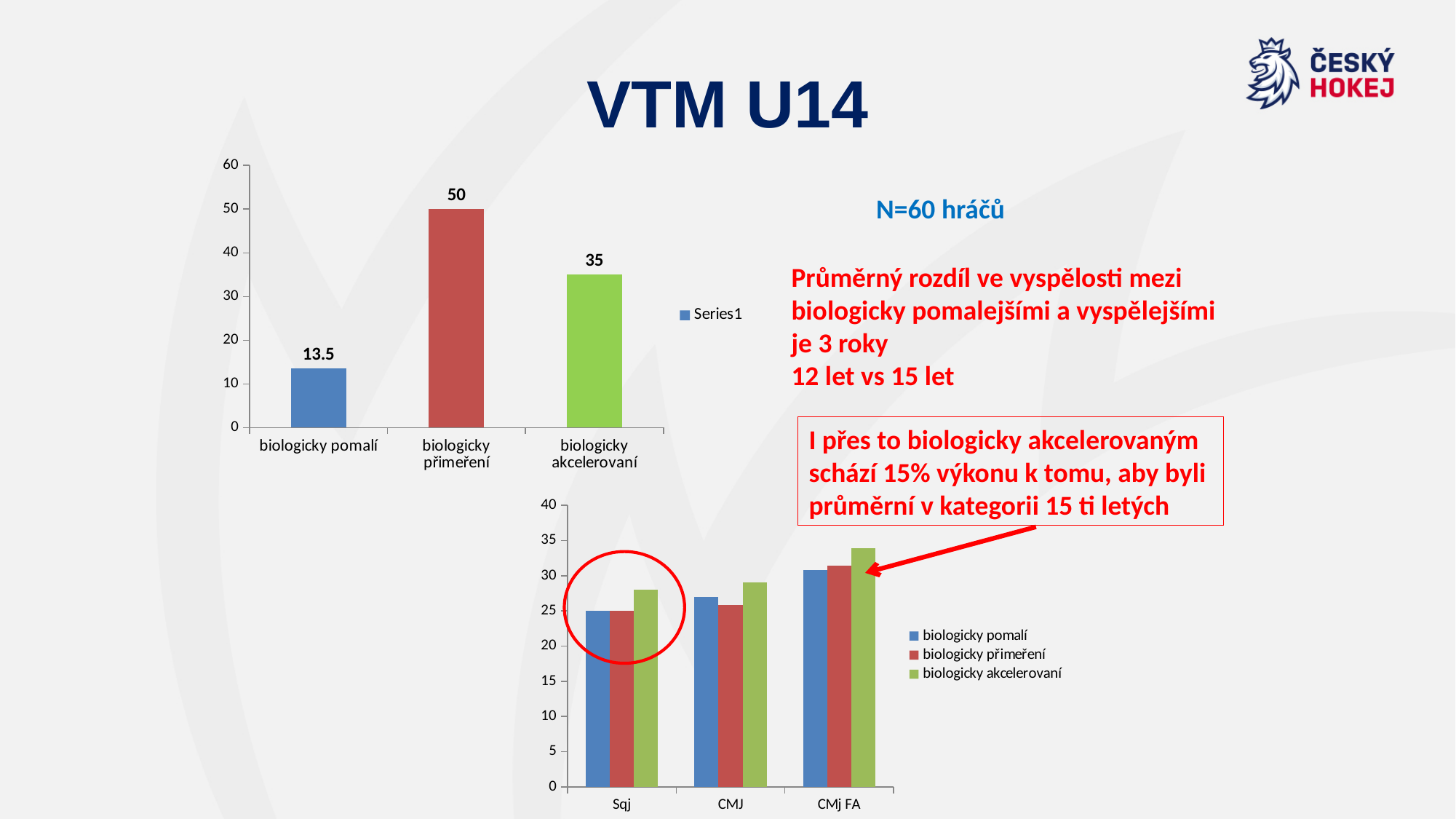
In the top-left chart, which category has the lowest value? biologicky pomalí In the bottom chart, do the values for biologicky pomalí rise or fall from Sqj to CMj FA? rise In the top-left chart, what is the difference between the values for biologicky přimeření and biologicky akcelerovaní? 15 In the bottom chart, is the value for biologicky akcelerovaní in CMj FA greater or less than 30? greater What kind of chart is the bottom chart? bar chart In the top-left chart, what is the value for biologicky přimeření? 50 In the top-left chart, which category has the highest value? biologicky přimeření In the top-left chart, what is the legend entry? Series1 In the bottom chart, how many categories are shown on the x axis? 3 In the top-left chart, what is the value for biologicky pomalí? 13.5 In the bottom chart, how many series does the legend list? 3 In the top-left chart, how many categories are shown on the x axis? 3